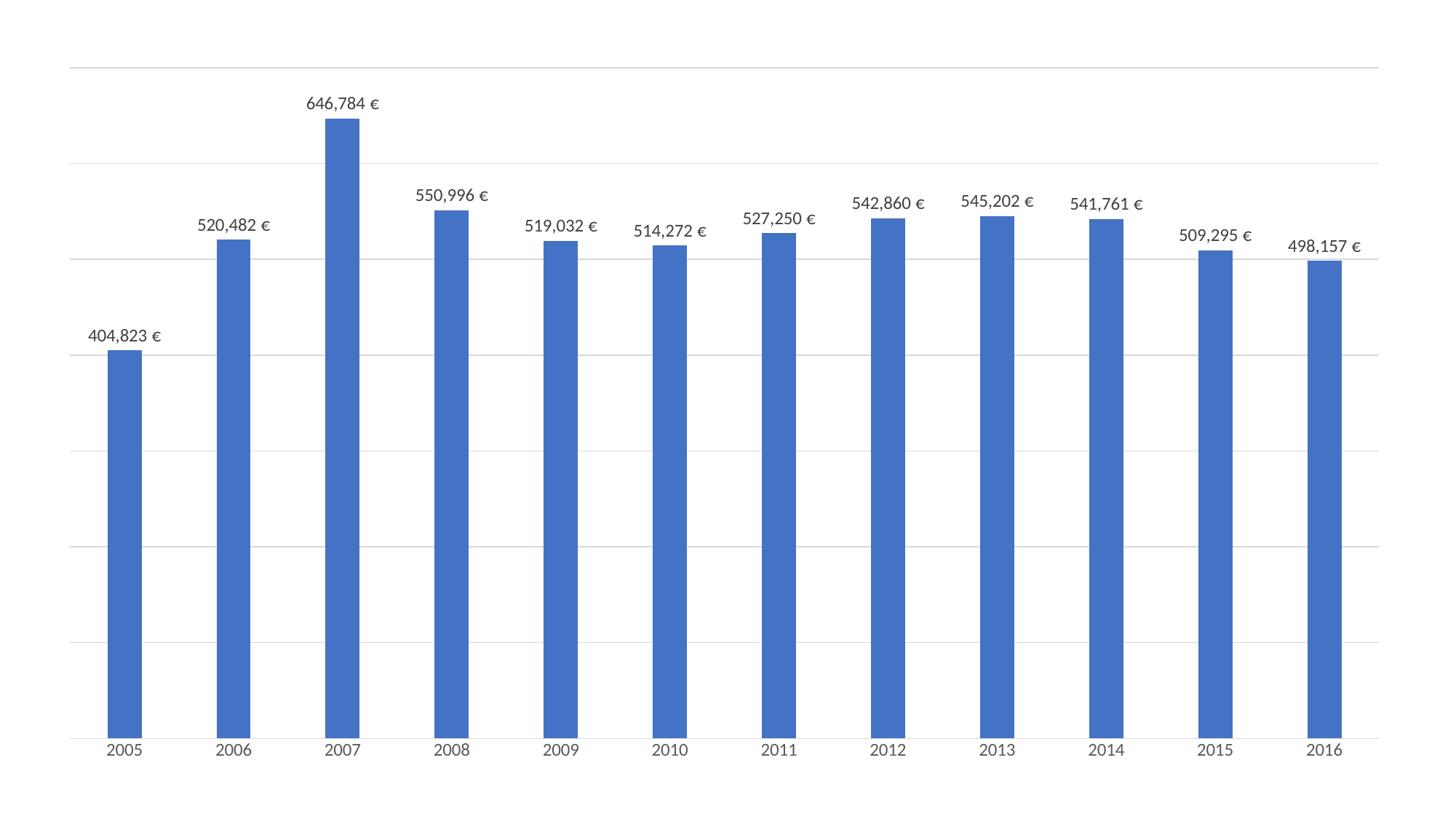
What is the value for 2007? 646,784 € What is the value for 2011? 527,250 € Which year has the highest value? 2007 Which is larger, the value for 2006 or the value for 2016? 2006 How many years are shown on the x axis? 12 What is the difference between the values for 2007 and 2005? 241,961 € What is the difference between the values for 2008 and 2009? 31,964 € Do the values rise or fall from 2013 to 2016? Fall What kind of chart is this? Bar chart What is the value for 2016? 498,157 € What is the value for 2005? 404,823 € Which year has the lowest value? 2005